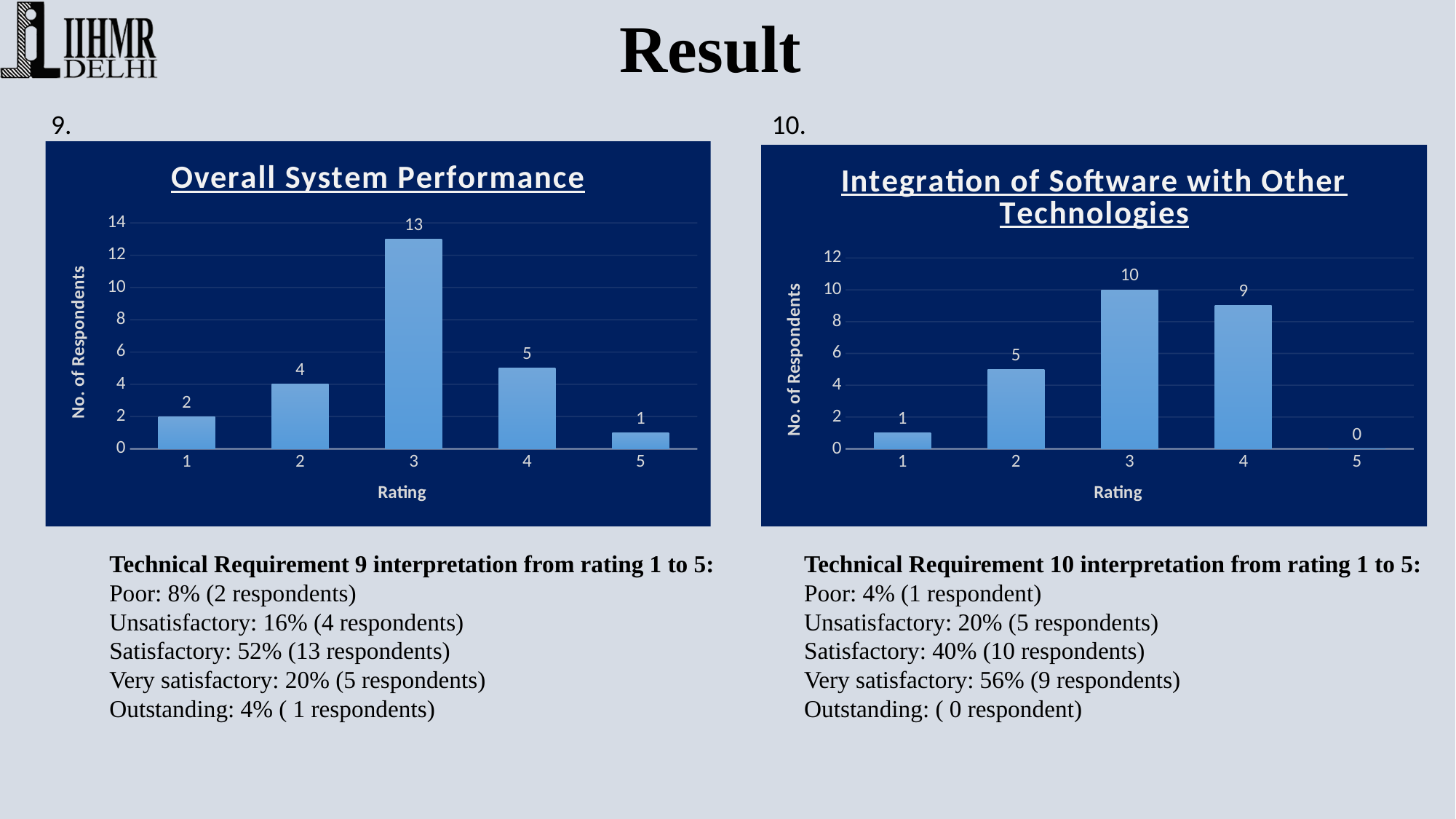
What is the y-axis label of the 'Integration of Software with Other Technologies' chart? No. of Respondents In the 'Integration of Software with Other Technologies' chart, which has more respondents: rating 2 or rating 4? Rating 4 In the 'Integration of Software with Other Technologies' chart, what is the difference between the number of respondents for rating 3 and rating 1? 9 In the 'Integration of Software with Other Technologies' chart, which rating has the highest number of respondents? 3 In the 'Overall System Performance' chart, how many respondents gave a rating of 3? 13 In the 'Overall System Performance' chart, which rating has the lowest number of respondents? 5 What type of chart is the 'Overall System Performance' chart? Bar chart In the 'Overall System Performance' chart, is the value for rating 3 greater or less than 12? greater In the 'Integration of Software with Other Technologies' chart, what is the value for rating 5? 0 In the 'Overall System Performance' chart, how many rating categories are shown on the x axis? 5 In the 'Overall System Performance' chart, what is the difference between the number of respondents for rating 3 and rating 4? 8 In the 'Integration of Software with Other Technologies' chart, how many respondents gave a rating of 4? 9